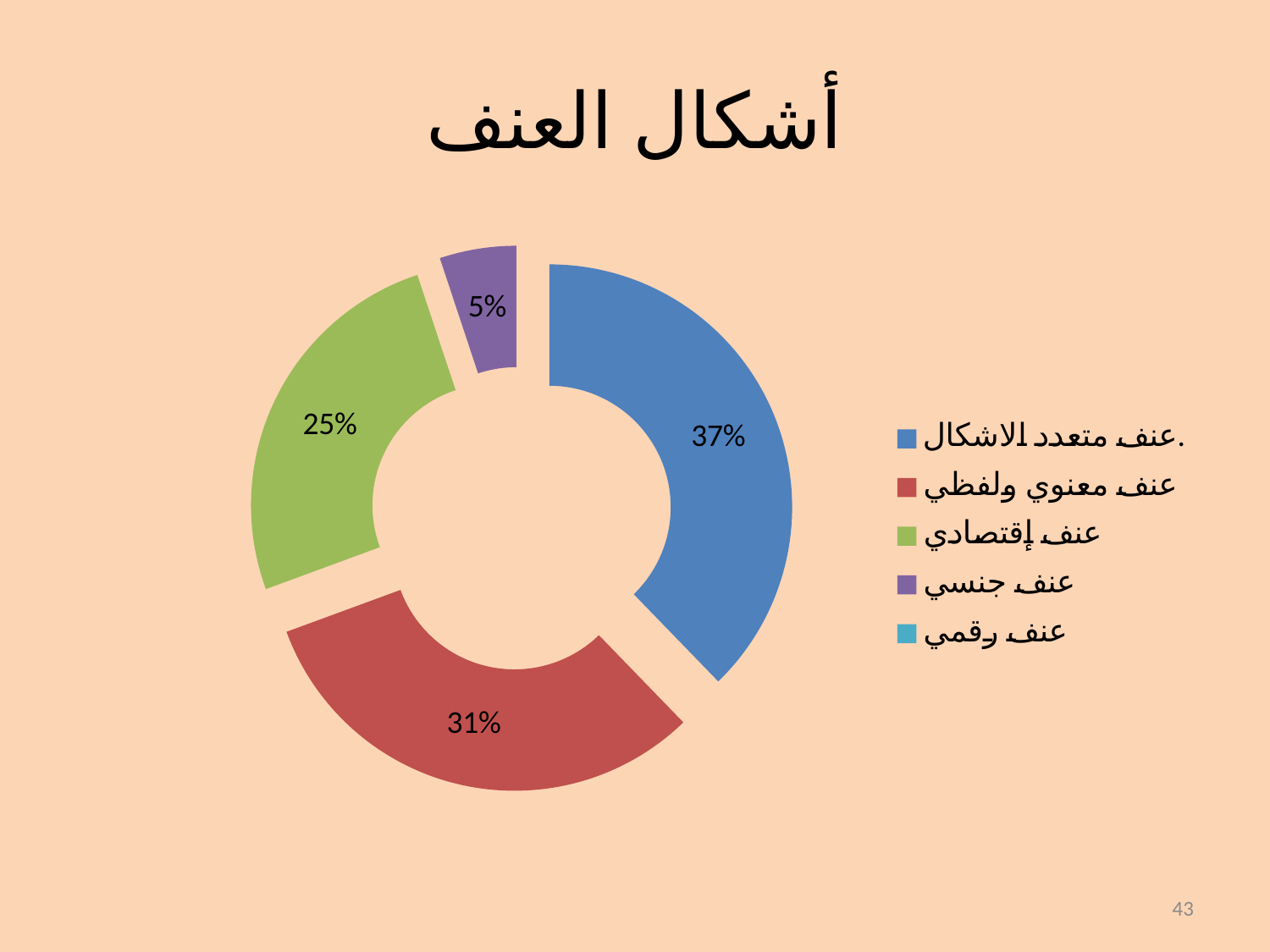
What percentage is shown for عنف معنوي ولفظي? 31% What is the difference in percentage points between عنف متعدد الاشكال and عنف معنوي ولفظي? 6 How many entries does the legend list? 5 Which category has the largest share of the chart? عنف متعدد الاشكال What percentage is shown for عنف متعدد الاشكال? 37% What is the title of the chart? أشكال العنف What colour is the slice for عنف معنوي ولفظي? Red Which is larger, the share for عنف إقتصادي or the share for عنف جنسي? عنف إقتصادي What percentage is shown for عنف إقتصادي? 25% What percentage is shown for عنف جنسي? 5% What kind of chart is shown on the slide? Doughnut (pie) chart Which labelled slice has the smallest share of the chart? عنف جنسي